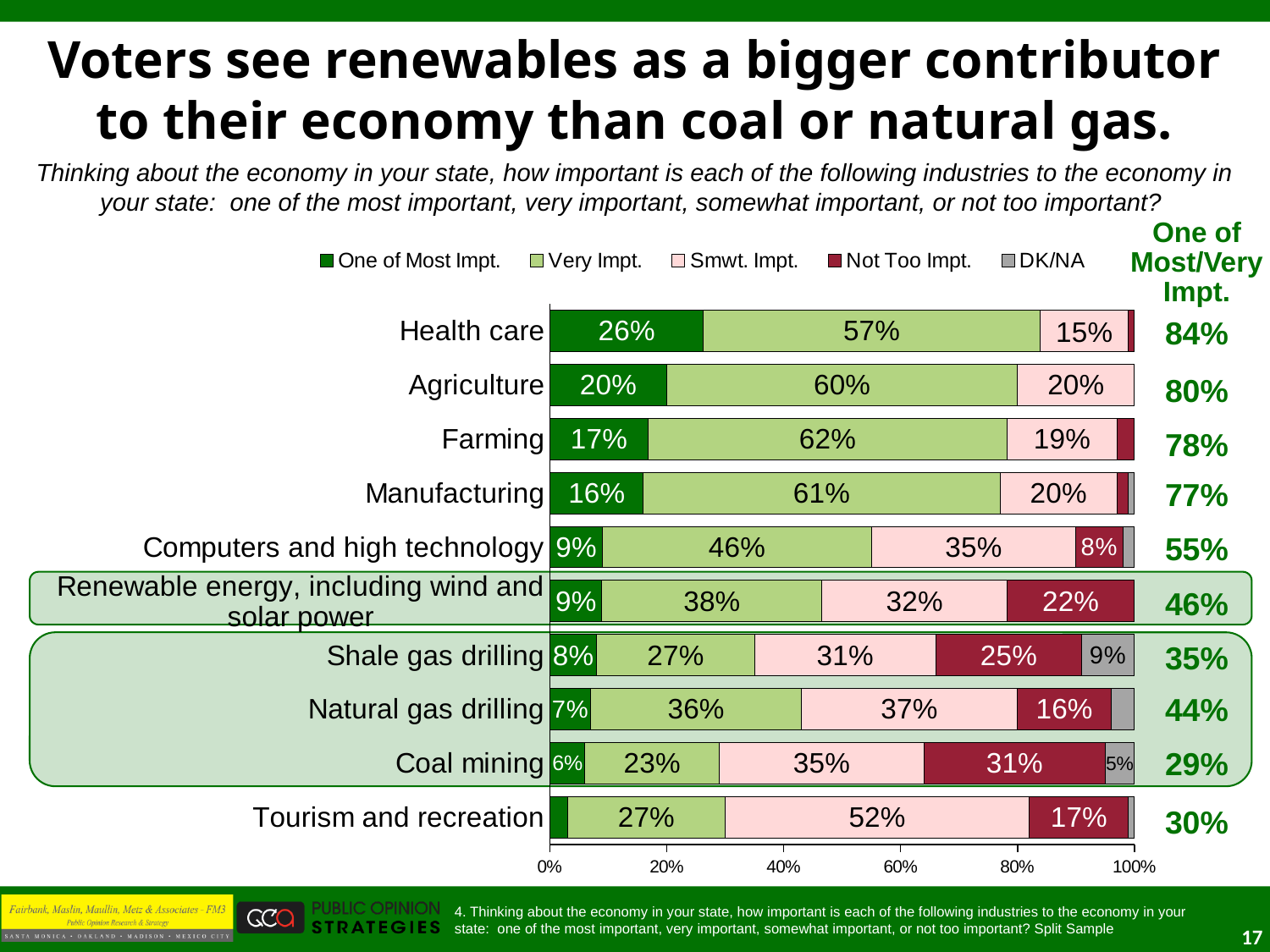
Which industry has the highest "One of Most/Very Impt." combined figure? Health care What is the difference between the "One of Most/Very Impt." figures for Renewable energy and Coal mining? 17% What is the "Smwt. Impt." value for Tourism and recreation? 52% Which has a larger "Very Impt." share: Natural gas drilling or Shale gas drilling? Natural gas drilling What is the combined "One of Most/Very Impt." figure shown for Renewable energy, including wind and solar power? 46% How many industries are shown in the chart? 10 What type of chart is shown on the slide? Stacked bar chart Which industry has the lowest "One of Most/Very Impt." combined figure? Coal mining What percentage of voters rate Health care as "Very Impt." to their state's economy? 57% Which legend entry is shown in dark green? One of Most Impt. How many response categories does the legend list? 5 What is the "Not Too Impt." value for Coal mining? 31%